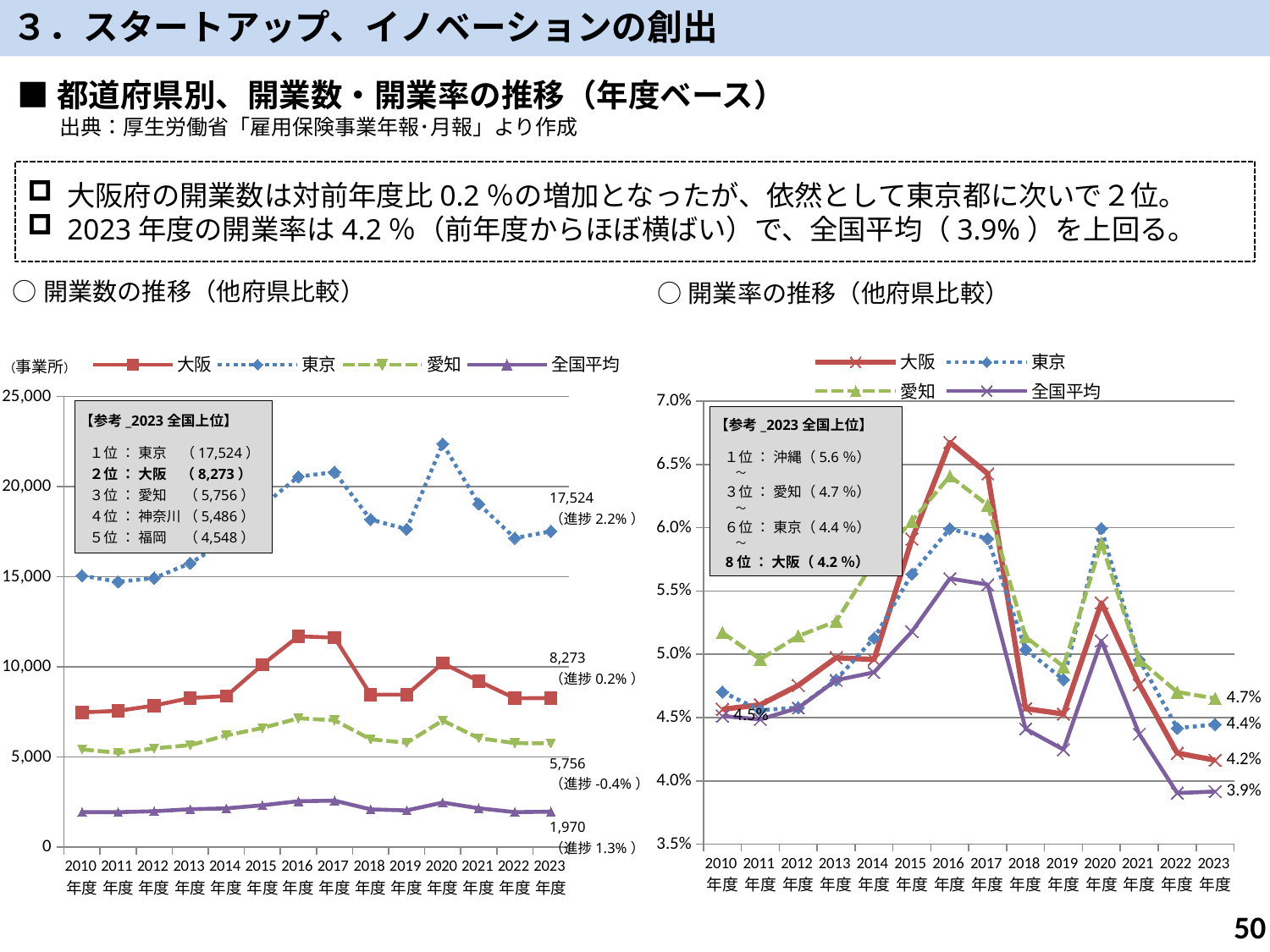
In the right chart (開業率の推移), which series has the lowest value in 2023? 全国平均 In the right chart (開業率の推移), what is the 2023 value for 全国平均? 3.9% In the left chart (開業数の推移), which series has the highest value in 2023? 東京 How many series does the legend of the right chart (開業率の推移) list? 4 In the left chart (開業数の推移), what is the 2023 value for 大阪? 8,273 In the right chart (開業率の推移), what is the 2023 value for 愛知? 4.7% In the right chart (開業率の推移), is the 2023 value for 大阪 larger or smaller than the 2023 value for 東京? smaller In the left chart (開業数の推移), how many years are plotted on the x axis? 14 In the left chart (開業数の推移), what is the 2023 value for 東京? 17,524 In the left chart (開業数の推移), what is the difference between the 2023 values for 東京 and 大阪? 9,251 In the left chart (開業数の推移), is the value for 大阪 in 2016 greater or less than 10,000? greater In the left chart (開業数の推移), what is the 2023 value for 全国平均? 1,970